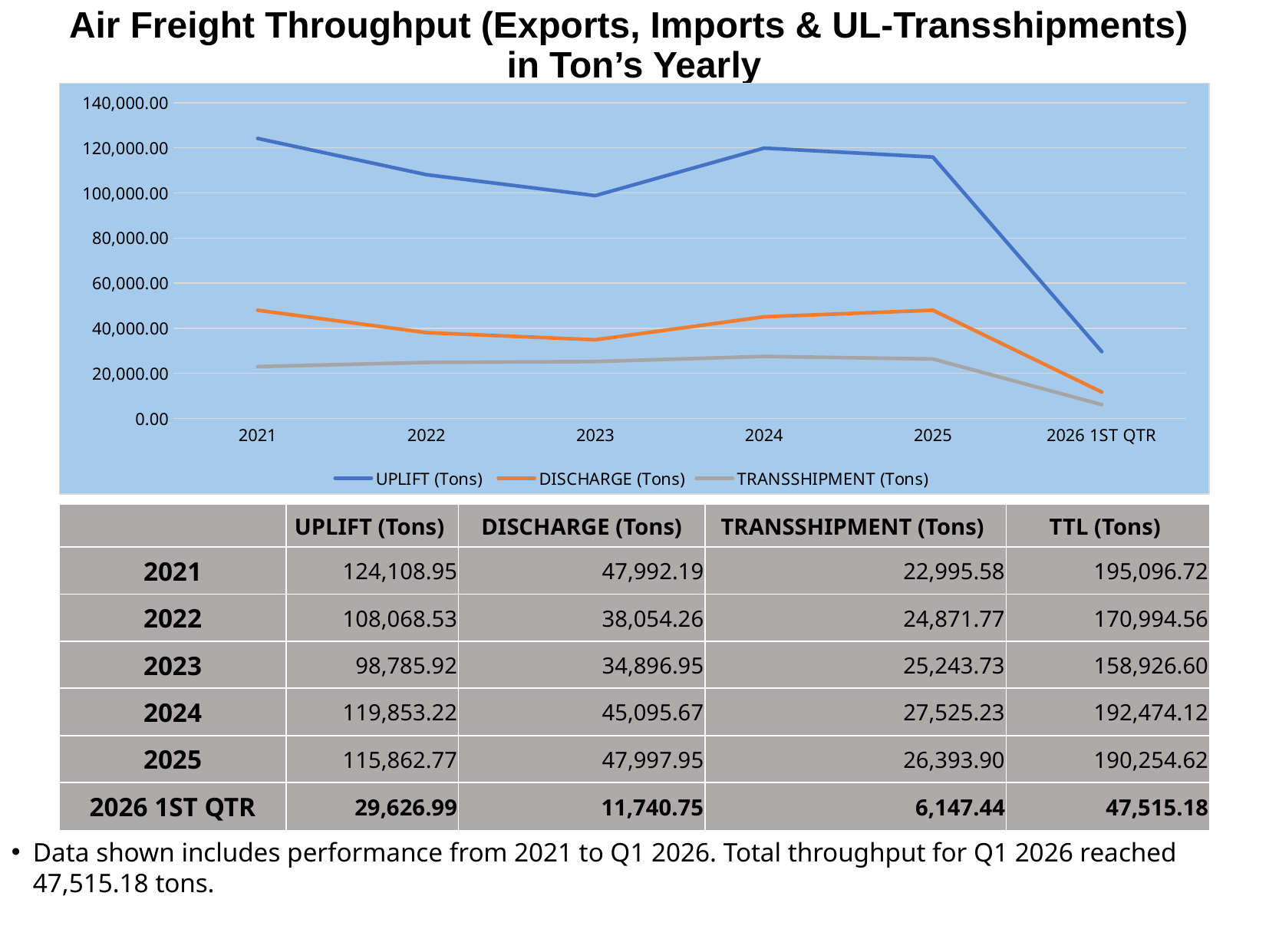
In which year is UPLIFT (Tons) highest? 2021 How many series does the chart legend list? 3 Which x-axis category has the lowest DISCHARGE (Tons) value? 2026 1ST QTR Which is larger, TRANSSHIPMENT (Tons) in 2024 or in 2022? 2024 What kind of chart is shown on the slide? line chart How many points are plotted along the x axis of the chart? 6 What is the DISCHARGE (Tons) value for 2024? 45,095.67 What is the difference between UPLIFT (Tons) in 2021 and in 2022? 16,040.42 What is the TRANSSHIPMENT (Tons) value for 2026 1ST QTR? 6,147.44 Is the UPLIFT (Tons) value for 2024 greater or less than 100,000.00? greater Does the UPLIFT (Tons) line rise or fall from 2021 to 2023? fall What is the UPLIFT (Tons) value for 2021? 124,108.95